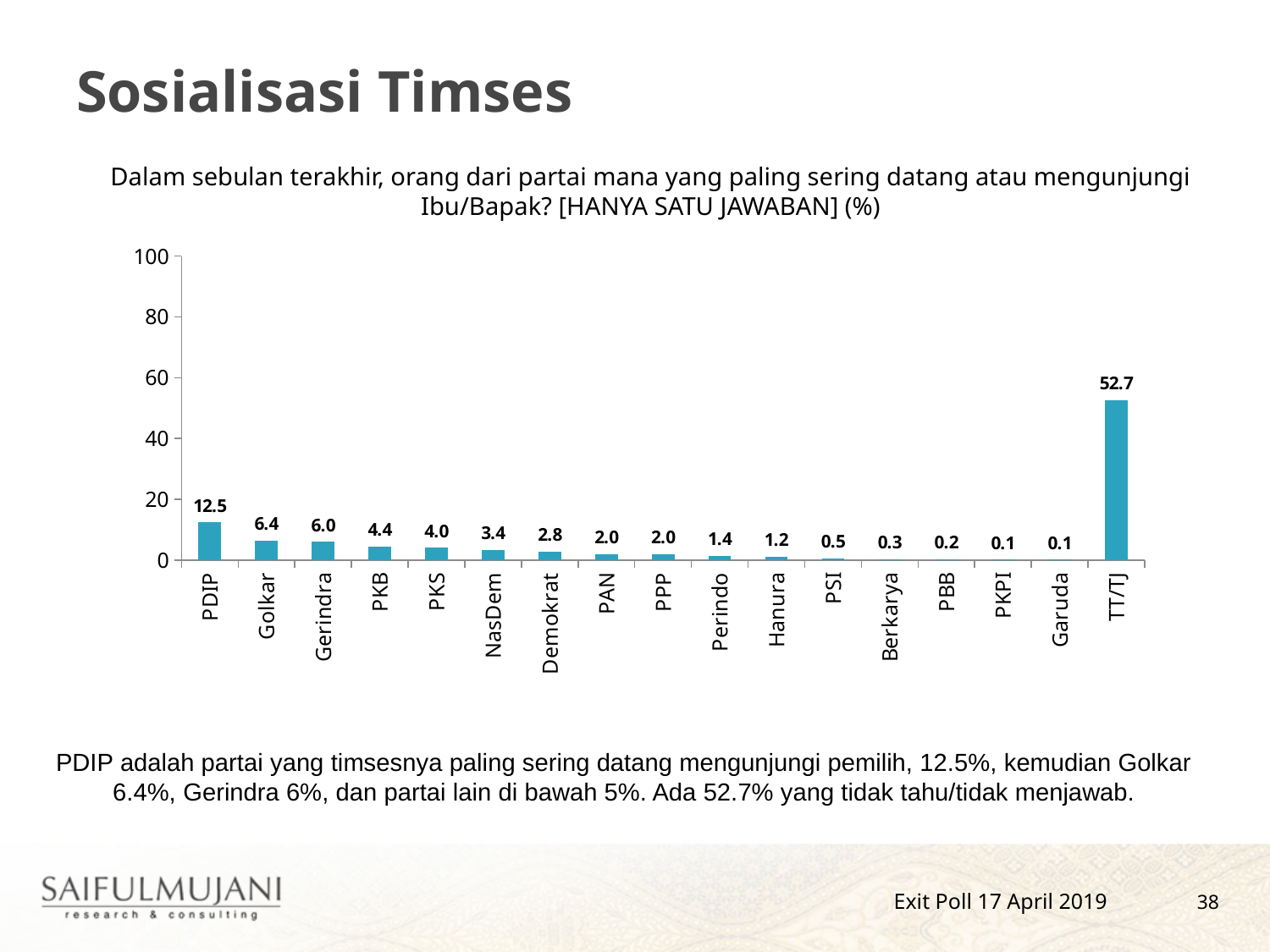
How many categories are shown on the x axis? 17 Which party (excluding TT/TJ) has the highest value? PDIP Is the value for TT/TJ greater or less than 40? greater What is the value for TT/TJ? 52.7 What is the value for Hanura? 1.2 What is the difference between the values for PDIP and Golkar? 6.1 What is the value for PDIP? 12.5 Which is larger, the value for Gerindra or the value for PKB? Gerindra What is the value for NasDem? 3.4 What is the title of the slide? Sosialisasi Timses Which category has the highest value? TT/TJ What kind of chart is shown on the slide? bar chart